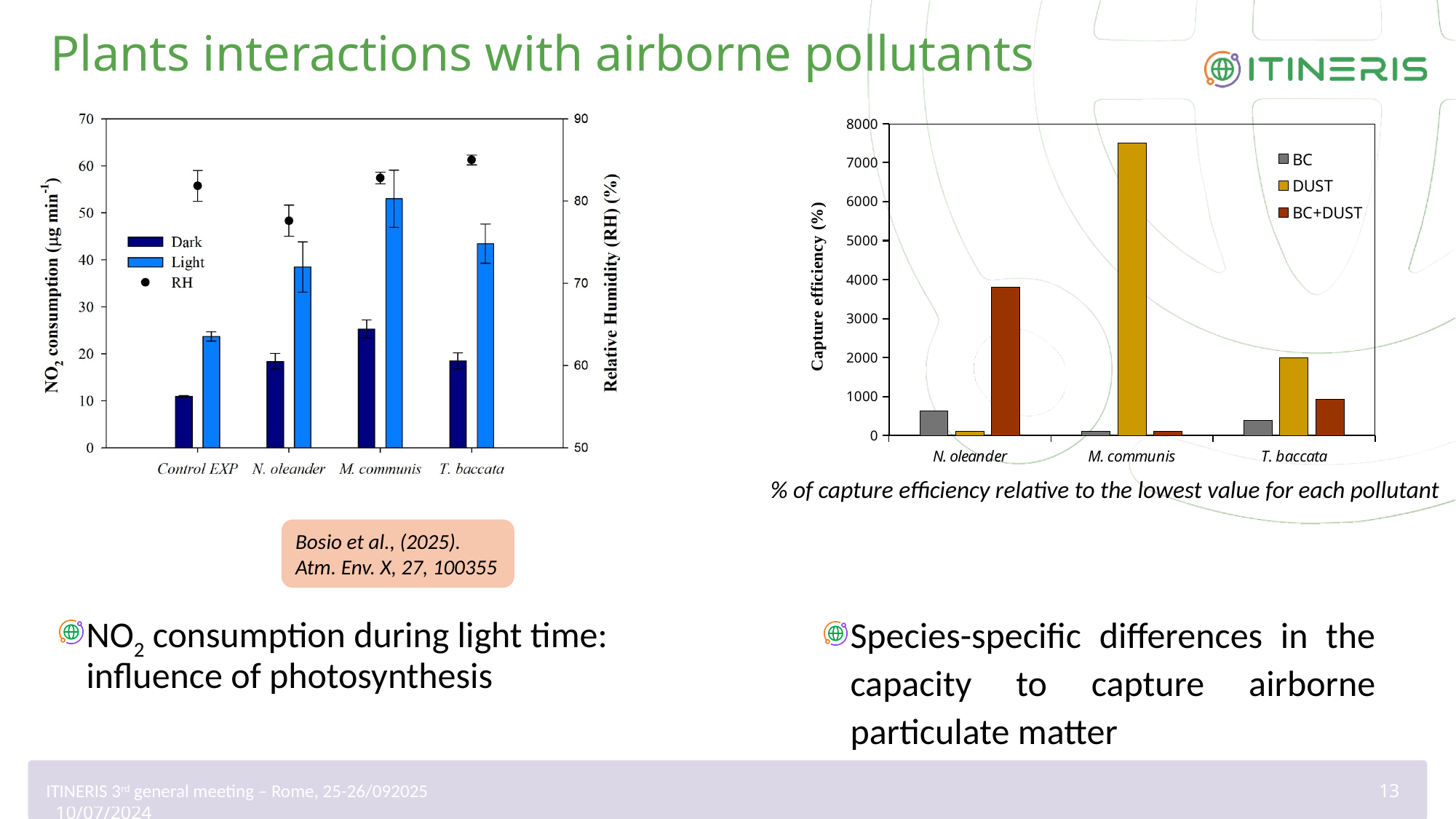
In the right-hand chart (Capture efficiency), which species has the highest BC+DUST capture efficiency? N. oleander In the left-hand chart (NO2 consumption), how many categories are shown on the x axis? 4 In the right-hand chart (Capture efficiency), how many species are shown on the x axis? 3 In the right-hand chart (Capture efficiency), which species has the highest DUST capture efficiency? M. communis In the left-hand chart (NO2 consumption), which species has the highest Light NO2 consumption? M. communis In the right-hand chart (Capture efficiency), which is larger for T. baccata: the DUST value or the BC+DUST value? DUST In the left-hand chart (NO2 consumption), which is larger for N. oleander: the Dark value or the Light value? Light In the right-hand chart (Capture efficiency), is the BC+DUST value for N. oleander greater or less than 3000? greater In the right-hand chart (Capture efficiency), how many series does the legend list? 3 In the left-hand chart (NO2 consumption), is the Light value for Control EXP greater or less than 20? greater In the right-hand chart (Capture efficiency), is the DUST value for M. communis greater or less than 7000? greater What is the y-axis label of the right-hand chart? Capture efficiency (%)